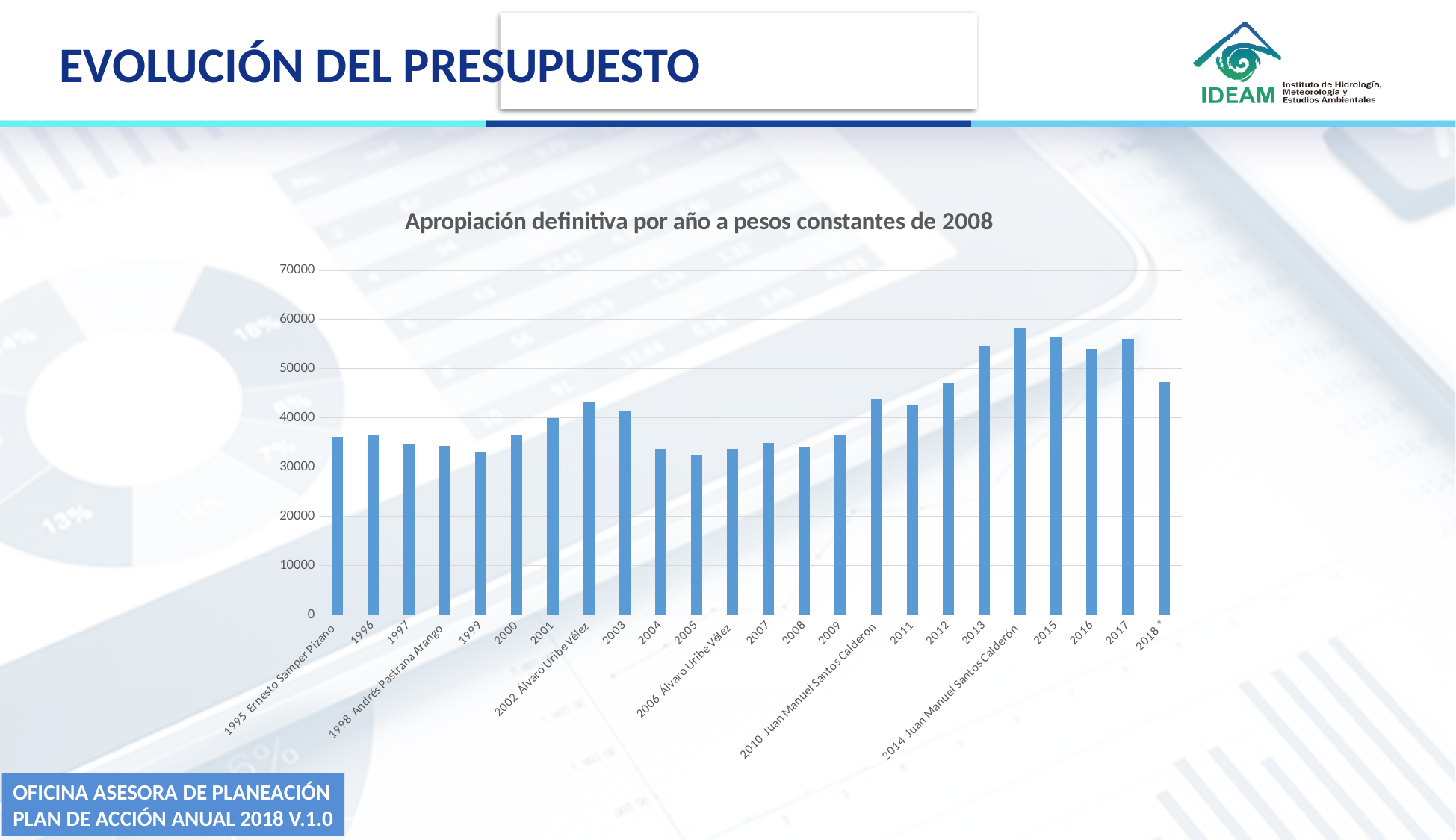
Is the value for 2018 * greater or less than 50000? less How many bars (years) are plotted in the chart? 24 What is the title of the chart? Apropiación definitiva por año a pesos constantes de 2008 What kind of chart is shown on the slide? bar chart Is the value for 2014 greater or less than 50000? greater Is the value for 2002 greater or less than 40000? greater Which is larger, the value for 2017 or the value for 2018 *? 2017 Do the values rise or fall from 2009 to 2014? rise Which year has the highest bar in the chart? 2014 Juan Manuel Santos Calderón Which is larger, the value for 2014 or the value for 2005? 2014